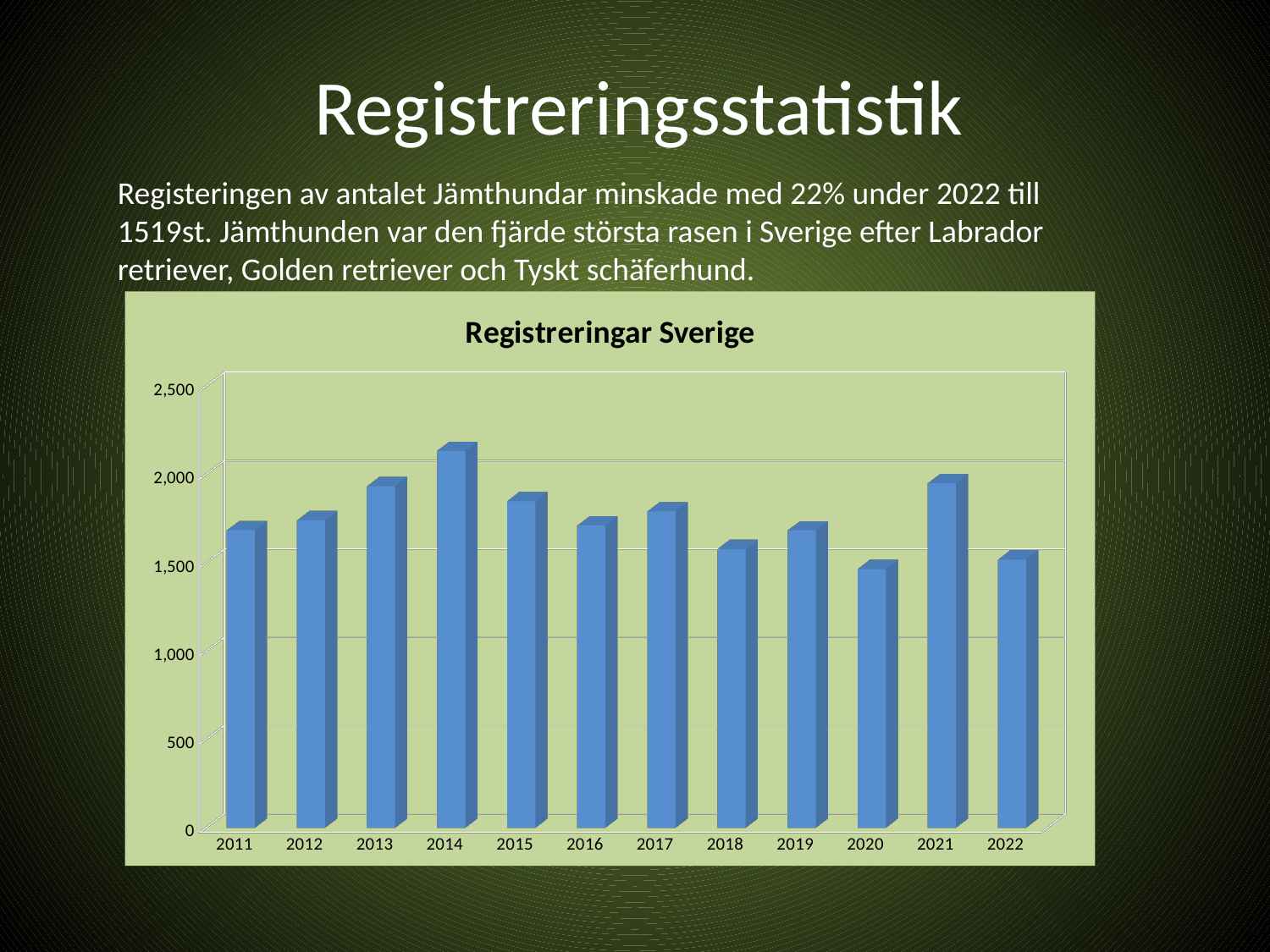
Is the value for 2014 greater or less than 2,000? greater What is the title of the chart? Registreringar Sverige Which year has the highest number of registrations in the chart? 2014 Is the value for 2011 greater or less than 1,500? greater How many years are shown on the x axis of the chart? 12 Which year has the larger value, 2021 or 2020? 2021 Is the value for 2013 greater or less than 2,000? less What kind of chart is shown on the slide? bar chart Which year has the larger value, 2013 or 2012? 2013 Do the values rise or fall from 2011 to 2014? rise